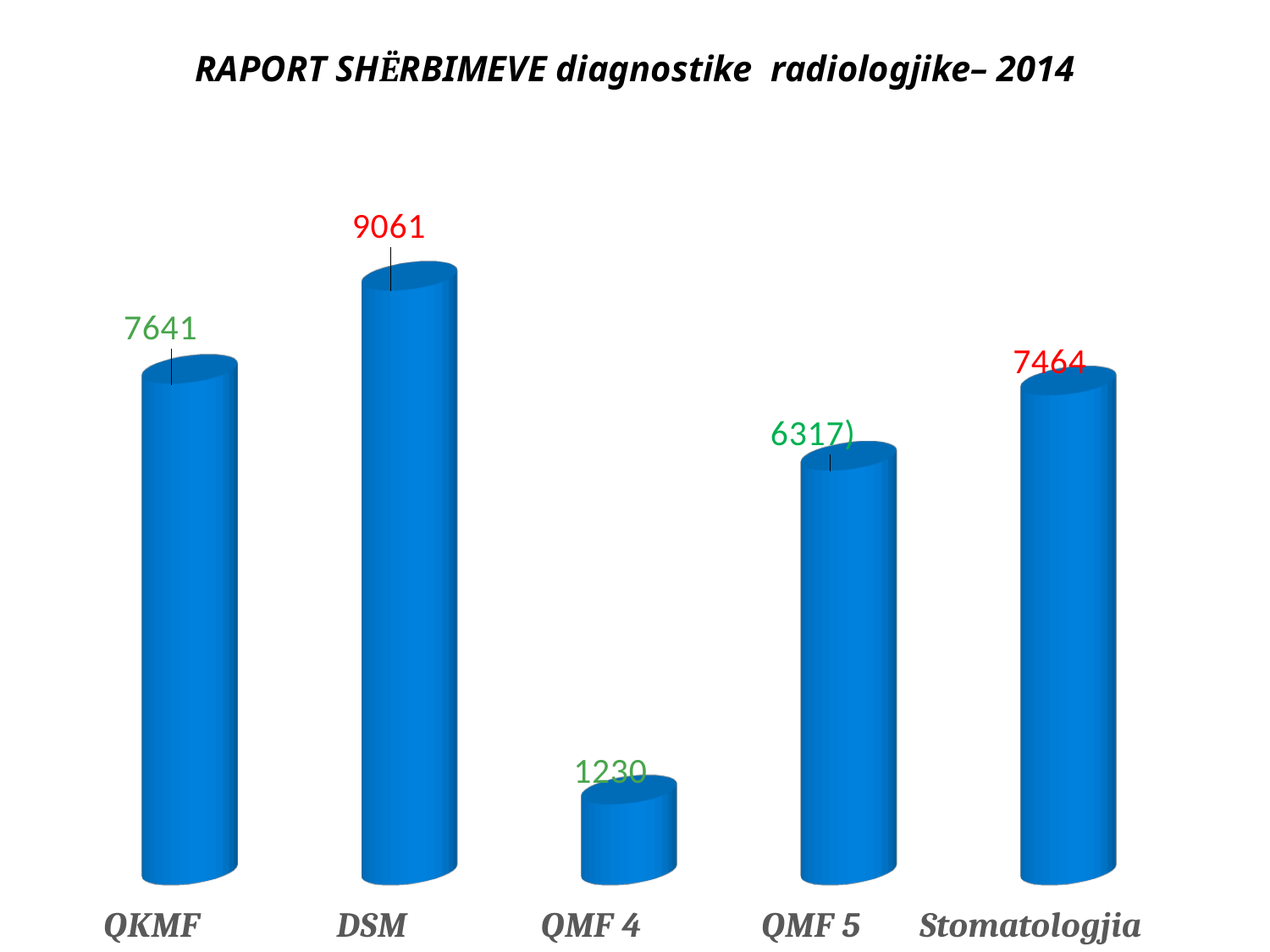
Which is larger, the value for QKMF or the value for Stomatologjia? QKMF What is the difference between the values for DSM and QKMF? 1420 What is the value for QKMF? 7641 What is the value for Stomatologjia? 7464 What is the value for QMF 4? 1230 What is the difference between the values for Stomatologjia and QMF 4? 6234 What kind of chart is shown on the slide? Bar chart What is the value for DSM? 9061 How many categories are shown in the chart? 5 Which category has the lowest value? QMF 4 What is the value for QMF 5? 6317 Which category has the highest value? DSM